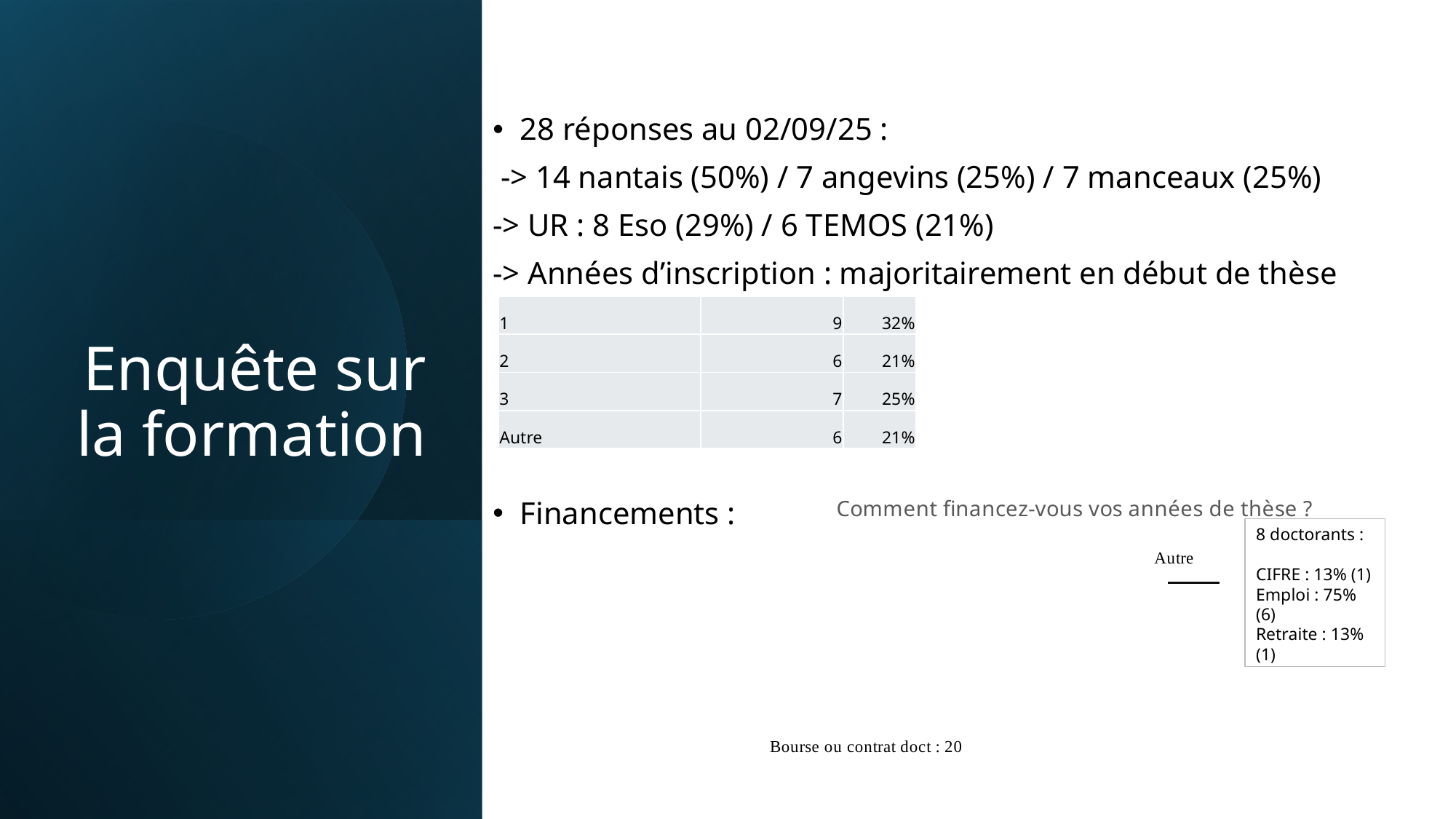
According to the annotation next to the chart, what share of the 'Autre' category is 'CIFRE'? 13% In the chart 'Comment financez-vous vos années de thèse ?', how many category labels are shown? 2 According to the annotation next to the chart, what share of the 'Autre' category is 'Emploi'? 75% In the chart 'Comment financez-vous vos années de thèse ?', which category has the larger value, 'Bourse ou contrat doct' or 'Autre'? Bourse ou contrat doct What is the title of the chart on the slide? Comment financez-vous vos années de thèse ? According to the annotation next to the chart 'Comment financez-vous vos années de thèse ?', how many doctorants are in the 'Autre' category? 8 In the chart 'Comment financez-vous vos années de thèse ?', is the value for 'Bourse ou contrat doct' greater or less than 10? greater In the chart 'Comment financez-vous vos années de thèse ?', what value is shown for 'Bourse ou contrat doct'? 20